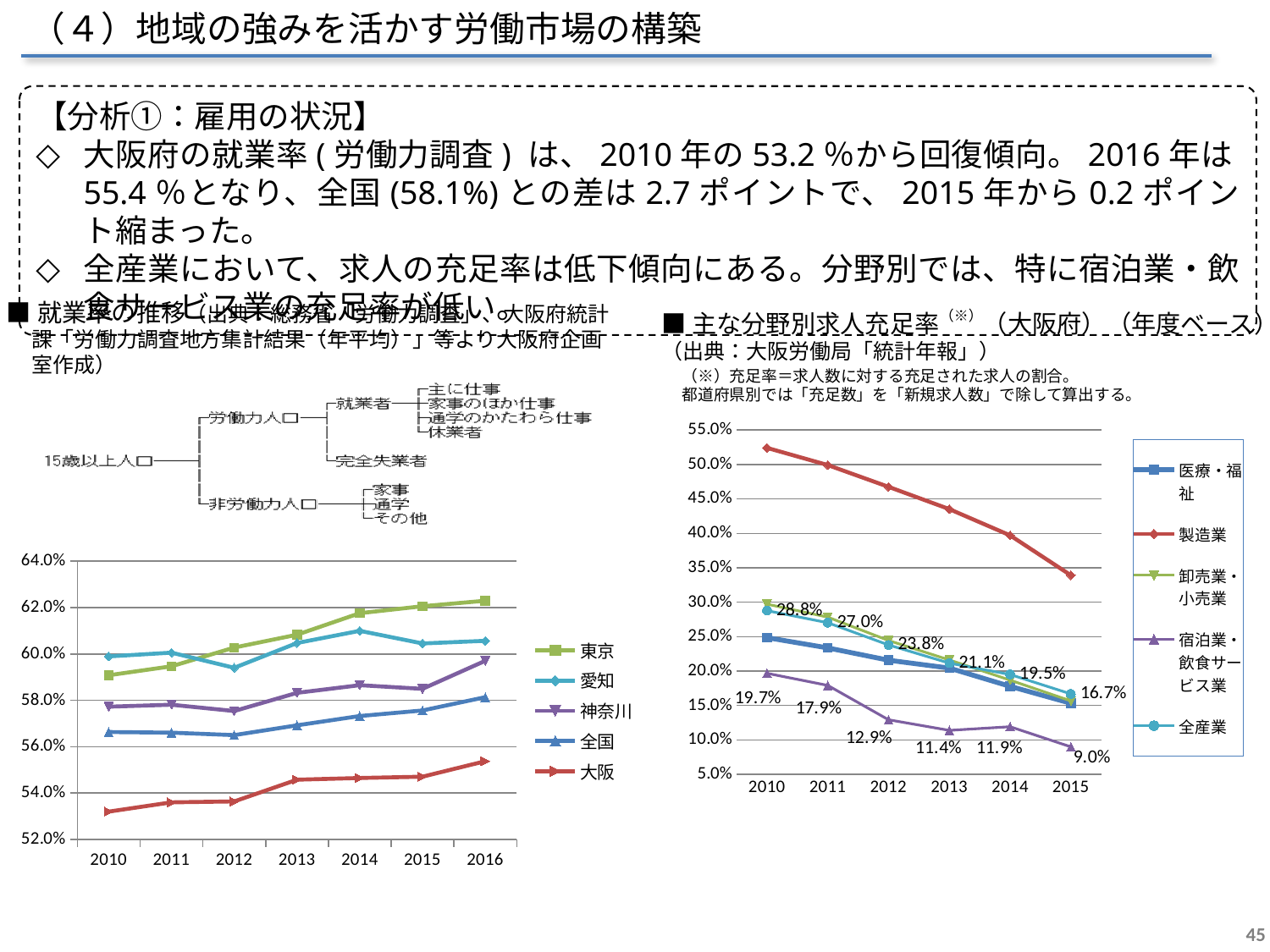
On the left chart (就業率の推移), how many series does the legend list? 5 On the right chart (主な分野別求人充足率), which series has the highest value in 2010? 製造業 On the right chart (主な分野別求人充足率), by how many percentage points did 全産業 fall from 2010 to 2015? 12.1 percentage points On the right chart (主な分野別求人充足率), is the value for 製造業 in 2010 greater or less than 50.0%? greater On the right chart (主な分野別求人充足率), what is the value for 全産業 in 2015? 16.7% On the left chart (就業率の推移), what kind of chart is it? Line chart On the left chart (就業率の推移), is the value for 大阪 in 2010 greater or less than 54.0%? less On the left chart (就業率の推移), which series has the lowest value in 2010? 大阪 On the left chart (就業率の推移), does the 大阪 series generally rise or fall from 2010 to 2016? rise On the right chart (主な分野別求人充足率), what is the value for 宿泊業・飲食サービス業 in 2015? 9.0% On the left chart (就業率の推移), which series has the highest value in 2016? 東京 On the left chart (就業率の推移), how many years are shown on the x axis? 7